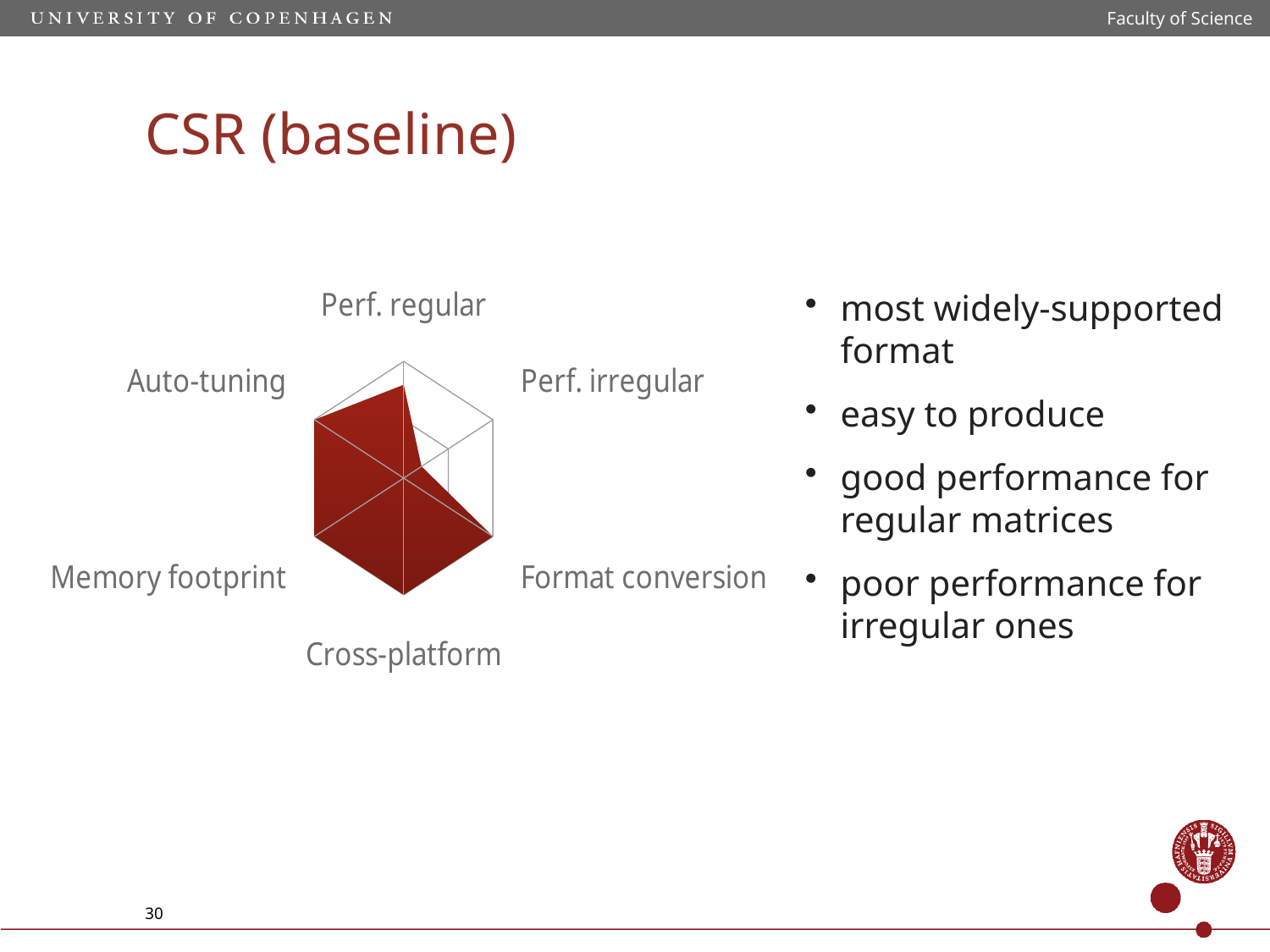
How many categories (axes) does the radar chart have? 6 Which category has the lowest value in the radar chart? Perf. irregular Which is larger in the radar chart, Format conversion or Perf. irregular? Format conversion Which is larger in the radar chart, Perf. regular or Perf. irregular? Perf. regular What kind of chart is shown on the slide? Radar chart What colour is the filled area of the radar chart? Dark red Which is larger in the radar chart, Memory footprint or Perf. irregular? Memory footprint Which category label appears at the top of the radar chart? Perf. regular